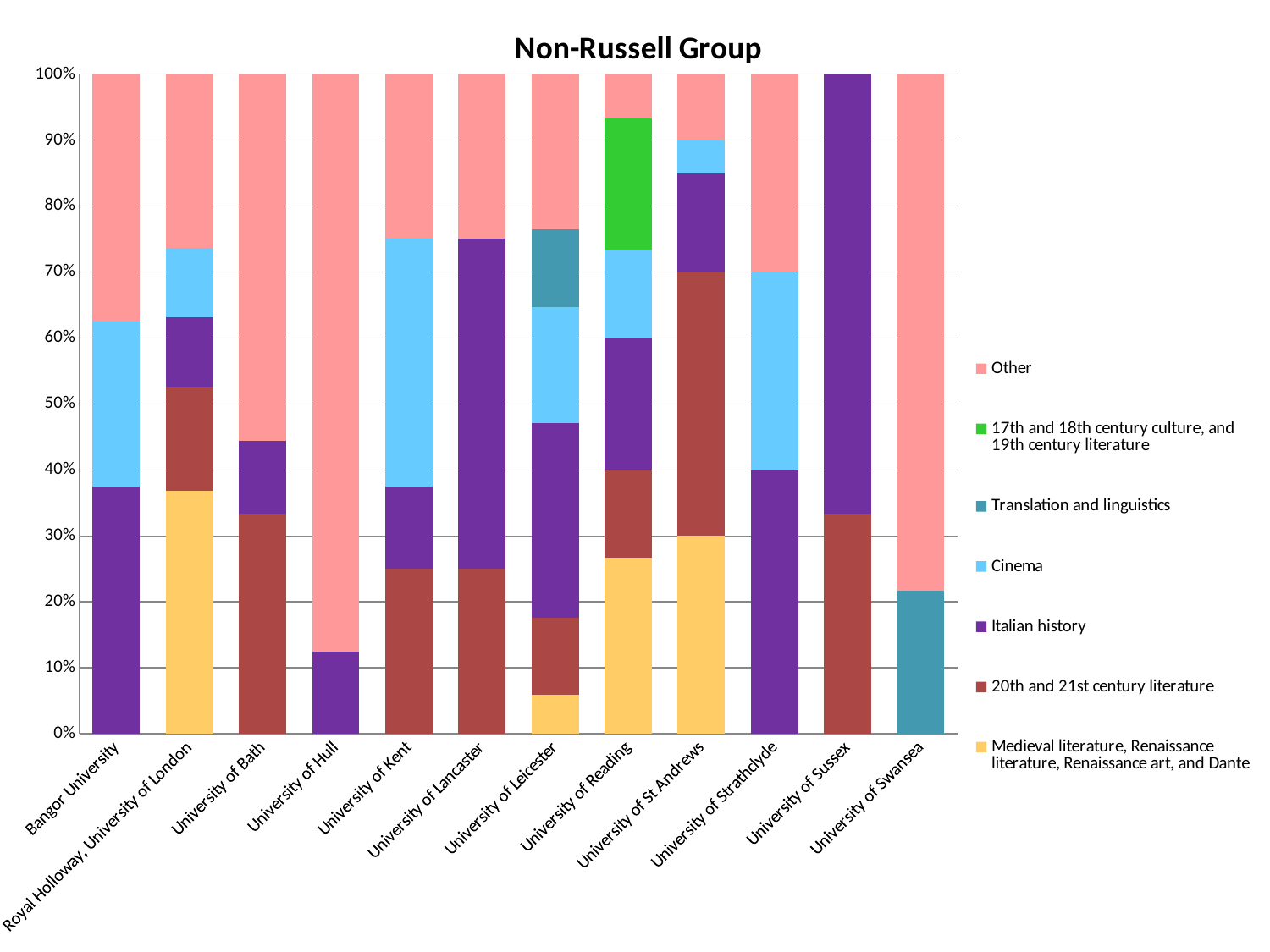
What share of the University of St Andrews bar is 'Other'? 10% How many series does the legend of the Non-Russell Group chart list? 7 Is the 'Other' share for University of Reading greater or less than 10%? less What share of the University of Strathclyde bar is 'Italian history'? 40% How many universities are shown on the x axis of the Non-Russell Group chart? 12 Which university has the largest 'Other' share? University of Hull Which university is the only one with a segment for '17th and 18th century culture, and 19th century literature'? University of Reading What kind of chart is shown on the slide? Stacked bar chart What share of the University of St Andrews bar is 'Medieval literature, Renaissance literature, Renaissance art, and Dante'? 30% Which university has the largest 'Other' share, University of Hull or University of Bath? University of Hull What is the title of the chart? Non-Russell Group Is the 'Other' share for University of Hull greater or less than 80%? greater